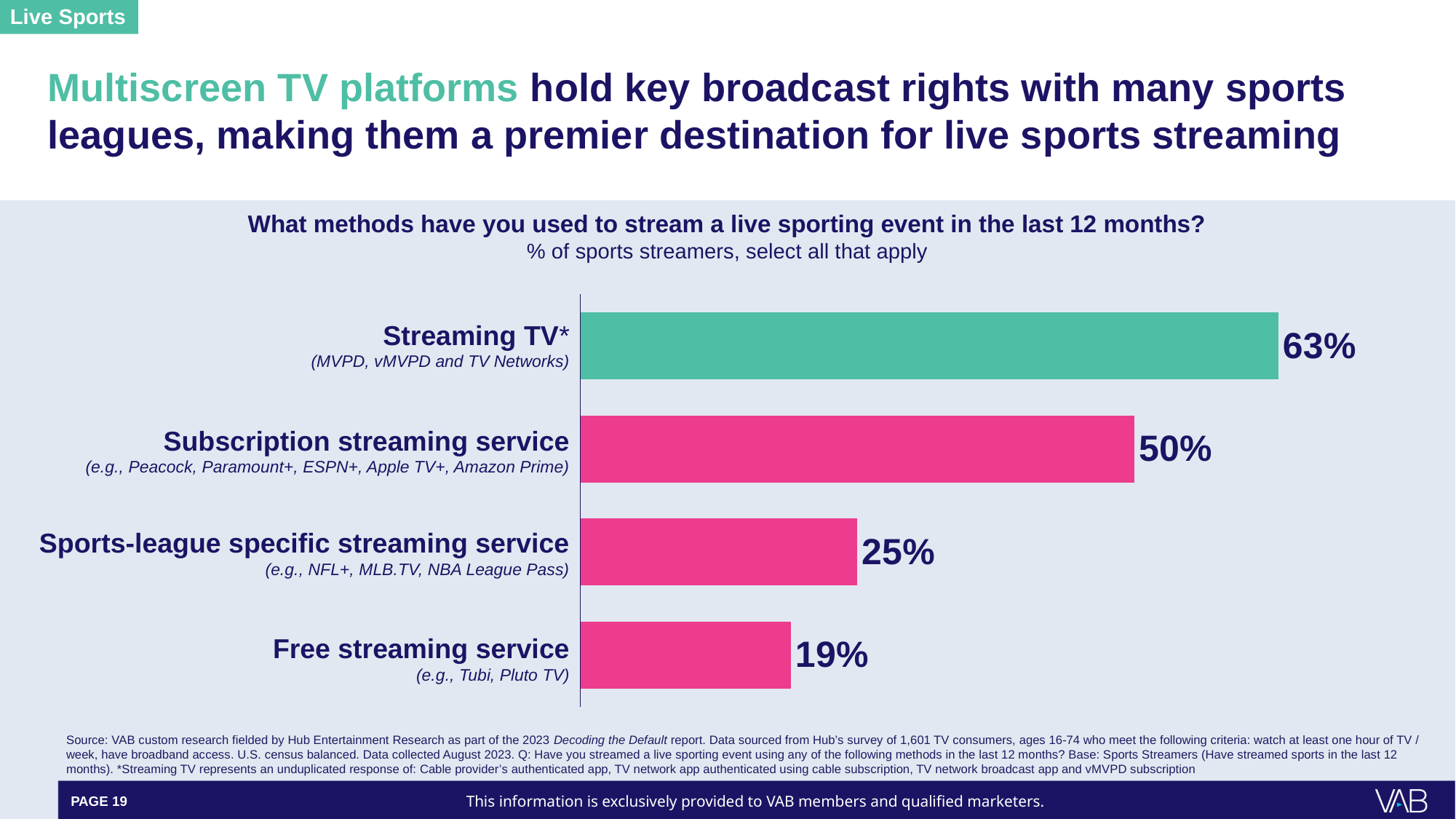
What is the difference in percentage points between Streaming TV and Subscription streaming service? 13 Which streaming method has the highest percentage? Streaming TV What is the difference between Sports-league specific streaming service and Free streaming service? 6 What is the chart's title question? What methods have you used to stream a live sporting event in the last 12 months? What is the value shown for Subscription streaming service? 50% How many streaming methods are shown in the chart? 4 What is the value for Free streaming service? 19% Which is larger: Subscription streaming service or Sports-league specific streaming service? Subscription streaming service What percentage is shown for Sports-league specific streaming service? 25% What percentage of sports streamers used Streaming TV to stream a live sporting event? 63% Which streaming method has the lowest percentage? Free streaming service What type of chart is shown on the slide? Bar chart